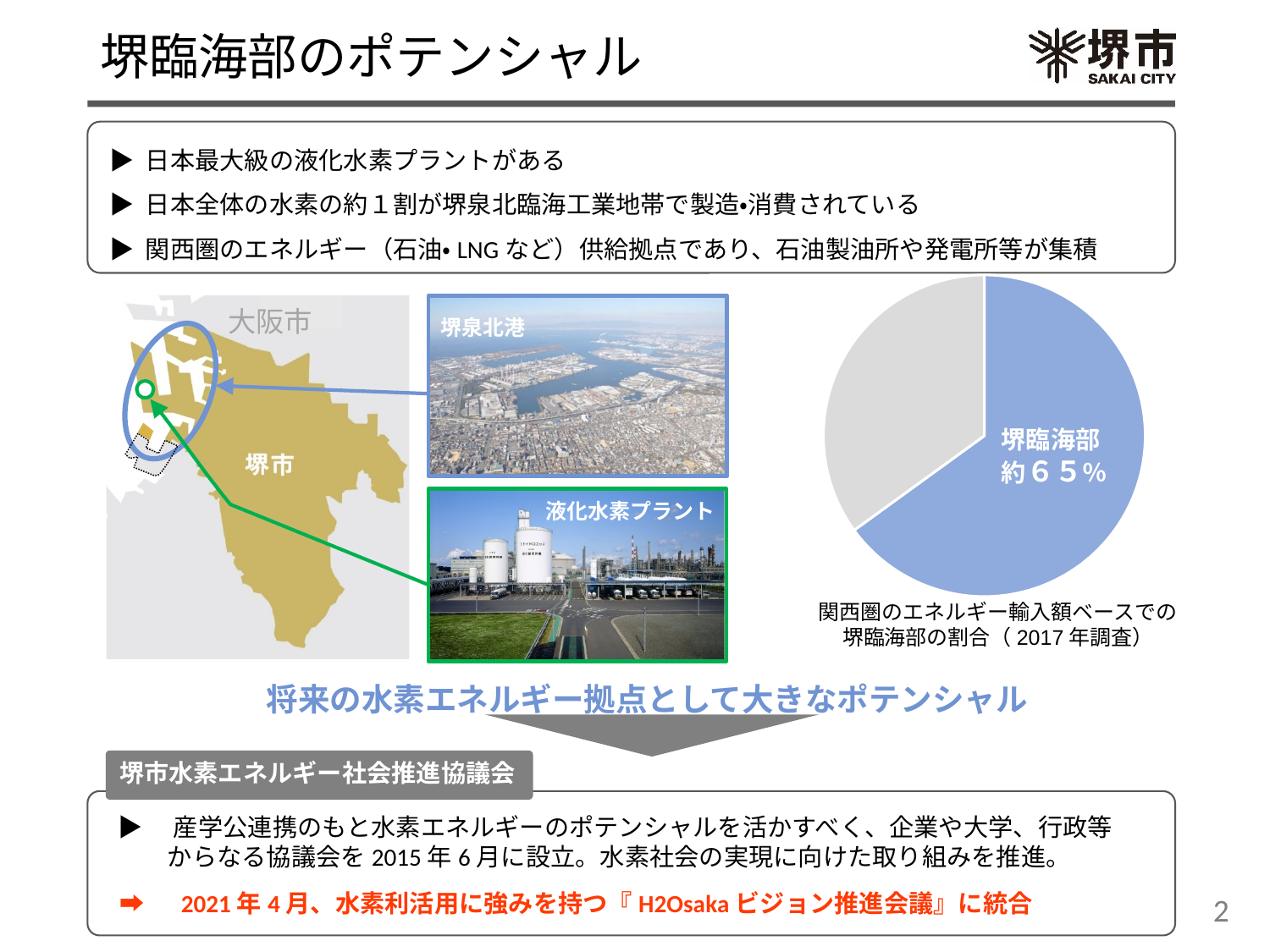
In the pie chart, is the share for 堺臨海部 greater or less than 50%? greater According to the caption under the pie chart, what survey year does the pie chart data come from? 2017年 What kind of chart is shown on the right side of the slide? pie chart What colour is the 堺臨海部 slice in the pie chart? blue Which slice of the pie chart is the largest? 堺臨海部 In the pie chart, which slice is larger: the blue slice (堺臨海部) or the gray slice? the blue slice (堺臨海部) How many slices does the pie chart have? 2 In the pie chart, what share is shown for 堺臨海部? 約６５%